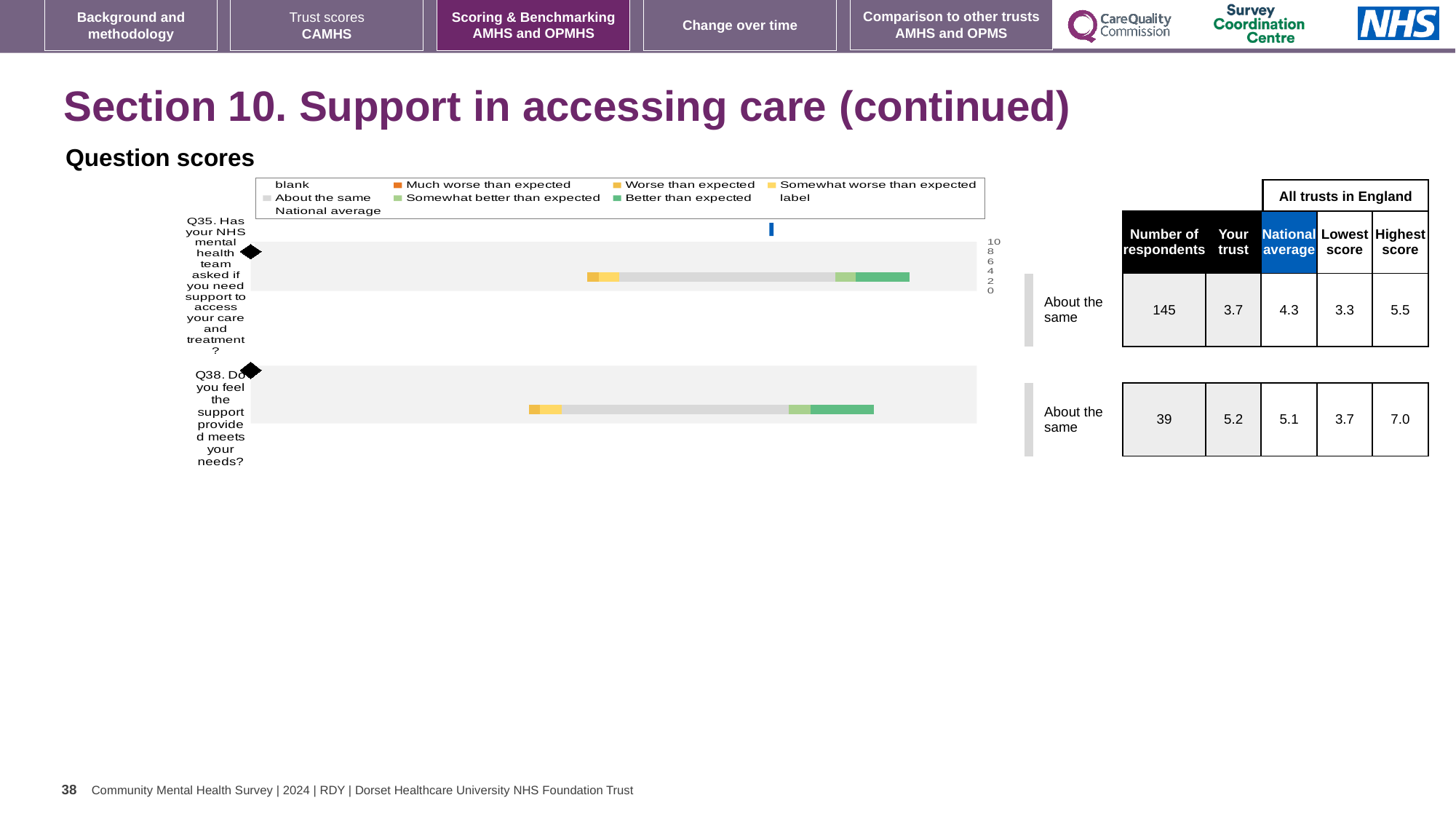
What is the 'Your trust' score shown for Q38? 5.2 How many questions (categories) are plotted in the question scores chart? 2 How many entries does the legend of the question scores chart list? 9 What is the national average score shown for Q35? 4.3 What is the difference between the highest score and the lowest score shown for Q38? 3.3 What benchmark category is shown next to the bar for Q38? About the same What is the difference between the national average and the 'Your trust' score for Q35? 0.6 What kind of chart is used to show the question scores on this slide? bar chart Which question has the larger 'Your trust' score, Q35 or Q38? Q38 What is the lowest score among all trusts in England shown for Q35? 3.3 What is the highest score among all trusts in England shown for Q38? 7.0 What is the number of respondents shown for Q35 in the table beside the chart? 145